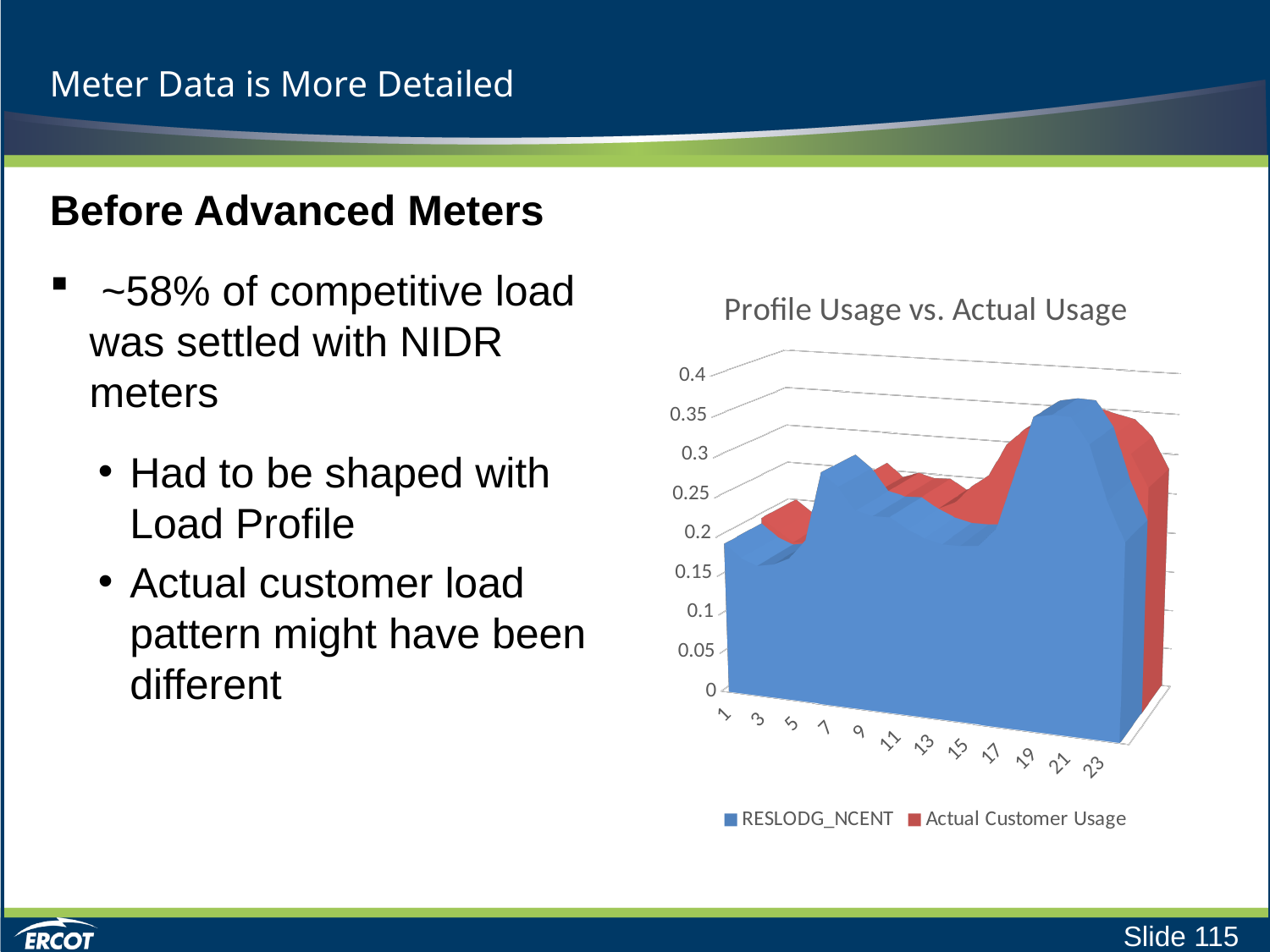
How many series does the chart's legend list? 2 What kind of chart is shown on the slide? Area chart Is the value of the RESLODG_NCENT series at x = 1 greater or less than 0.3? less Is the peak value of the Actual Customer Usage series greater or less than 0.3? greater Is the value of the RESLODG_NCENT series at x = 1 greater or less than 0.1? greater Does the RESLODG_NCENT series rise or fall between x = 21 and x = 23? fall Which series in the chart is shown in red? Actual Customer Usage What is the title of the chart on the slide? Profile Usage vs. Actual Usage Does the RESLODG_NCENT series rise or fall between x = 17 and x = 21? rise